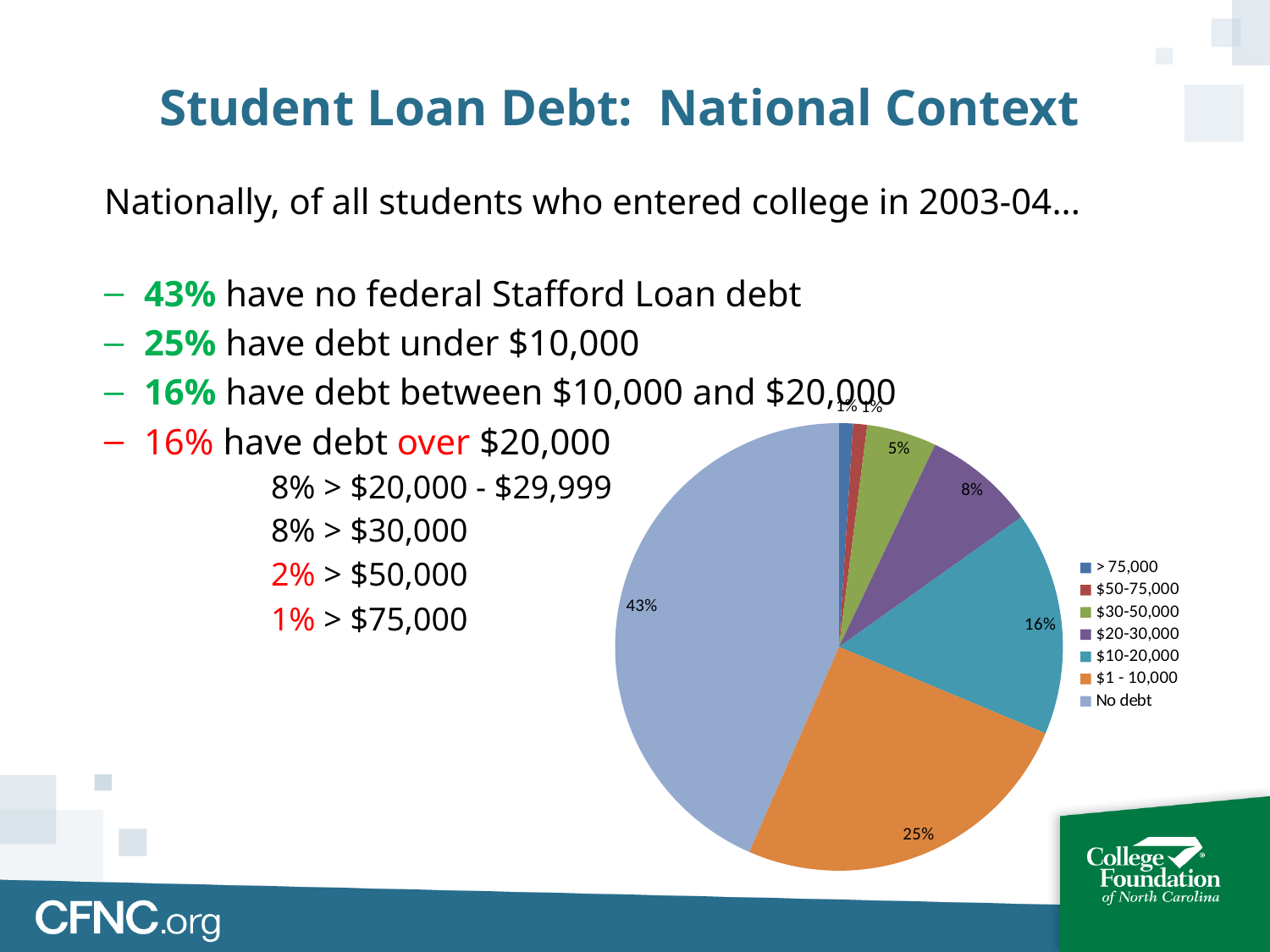
What is the combined share of the "$10-20,000" and "$20-30,000" slices? 24% What percentage is shown for the "$10-20,000" slice? 16% What kind of chart is shown on the slide? pie chart How many categories does the legend of the pie chart list? 7 What percentage is shown for the "$1 - 10,000" slice? 25% Which category has the largest slice of the pie? No debt What percentage is shown for the "$30-50,000" slice? 5% Which slice is larger, "$10-20,000" or "$20-30,000"? $10-20,000 What share of the pie does the "No debt" slice represent? 43% What is the difference between the "No debt" slice and the "$1 - 10,000" slice? 18% What colour is the "No debt" slice in the pie chart? light blue What percentage is shown for the "$20-30,000" slice? 8%